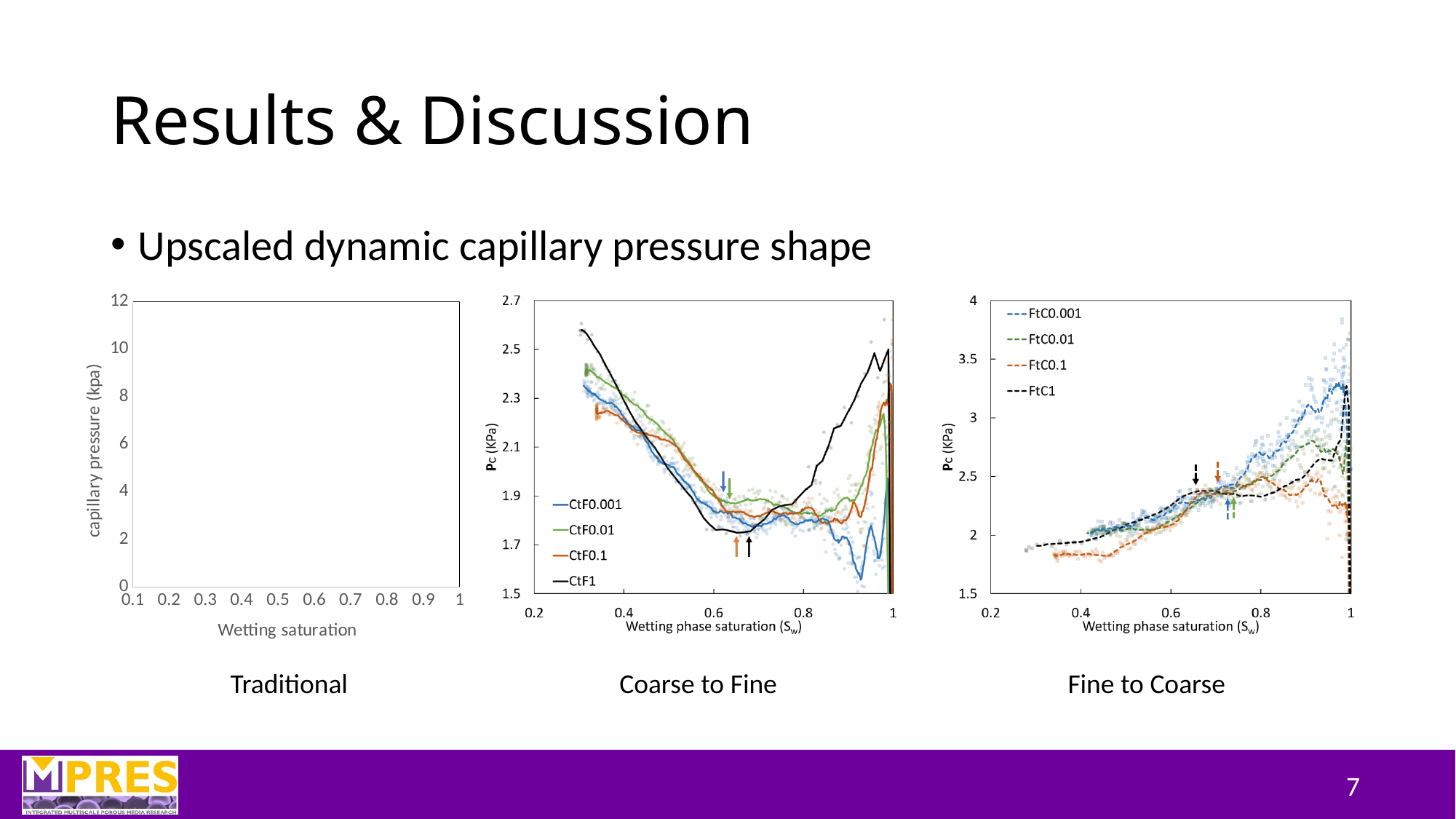
In the Coarse to Fine chart, which series reaches the highest Pc value near a wetting phase saturation of 0.3? CtF1 In the Coarse to Fine chart, does the CtF1 line rise or fall as wetting phase saturation increases from 0.3 to 0.6? fall In the Fine to Coarse chart, which series reaches a higher Pc value at a wetting phase saturation of 0.95, FtC0.001 or FtC0.1? FtC0.001 In the Coarse to Fine chart, is the Pc value of CtF1 at a wetting phase saturation of 0.3 greater or less than 2.5? greater What kind of chart is the Coarse to Fine chart? line chart In the Fine to Coarse chart, is the Pc value of FtC0.001 at a wetting phase saturation of 0.95 greater or less than 3? greater In the Fine to Coarse chart, how many series does the legend list? 4 How many charts are shown on the slide? 3 In the Coarse to Fine chart, how many series does the legend list? 4 In the Fine to Coarse chart, do the Pc values generally rise or fall as wetting phase saturation increases from 0.4 to 0.9? rise In the Coarse to Fine chart, which series drops to the lowest Pc value on the chart? CtF0.001 What is the x-axis label of the Traditional chart? Wetting saturation